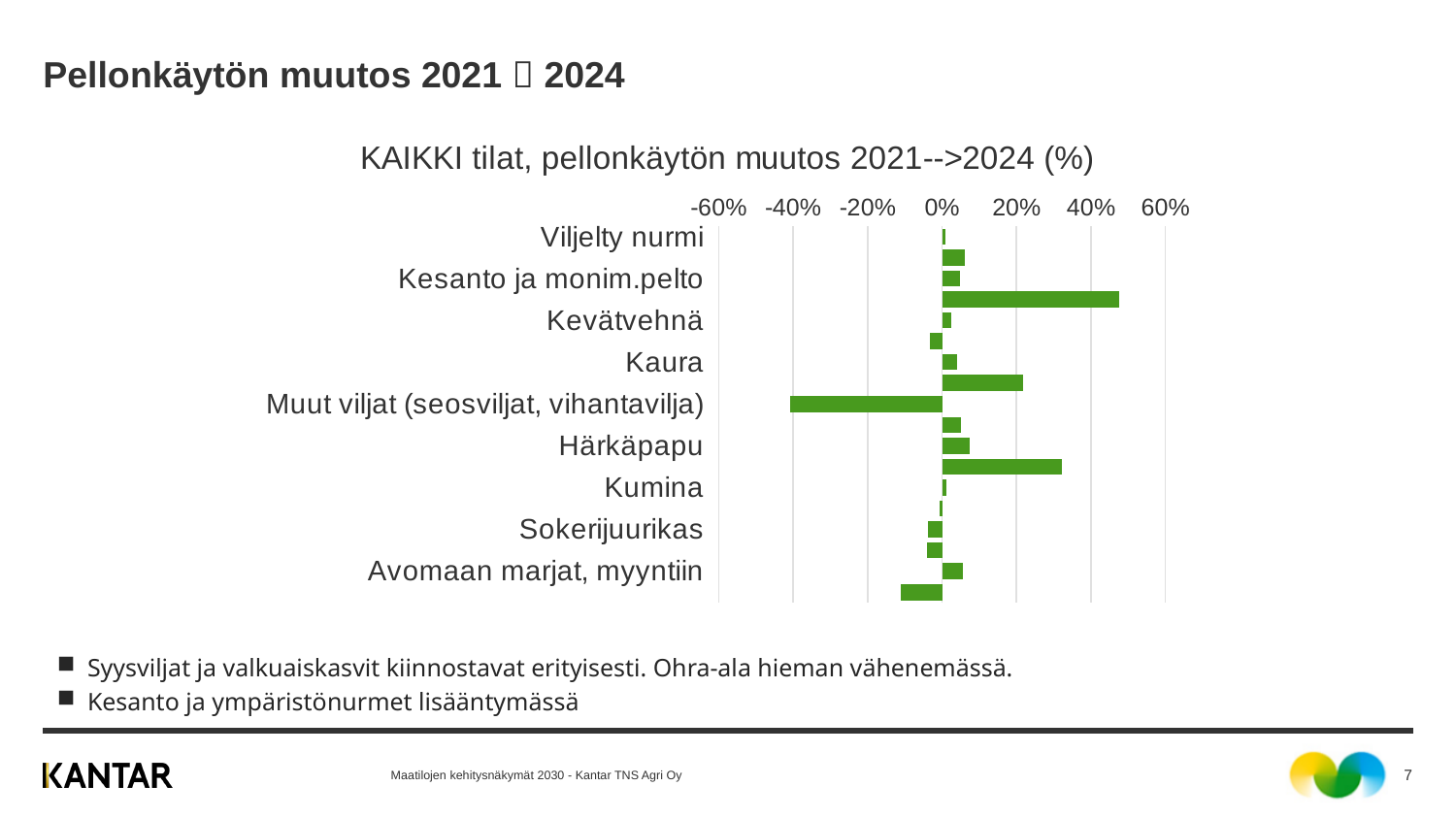
What kind of chart is shown on the slide? bar chart Is the value for Muut viljat (seosviljat, vihantavilja) greater or less than -20%? less How many category labels are listed on the vertical axis of the chart? 9 What is the title of the chart? KAIKKI tilat, pellonkäytön muutos 2021-->2024 (%) What colour are the bars in the chart? green Is the value for Muut viljat (seosviljat, vihantavilja) positive or negative? negative What is the lowest value shown on the horizontal axis? -60% Which labelled category has the longest negative bar? Muut viljat (seosviljat, vihantavilja)